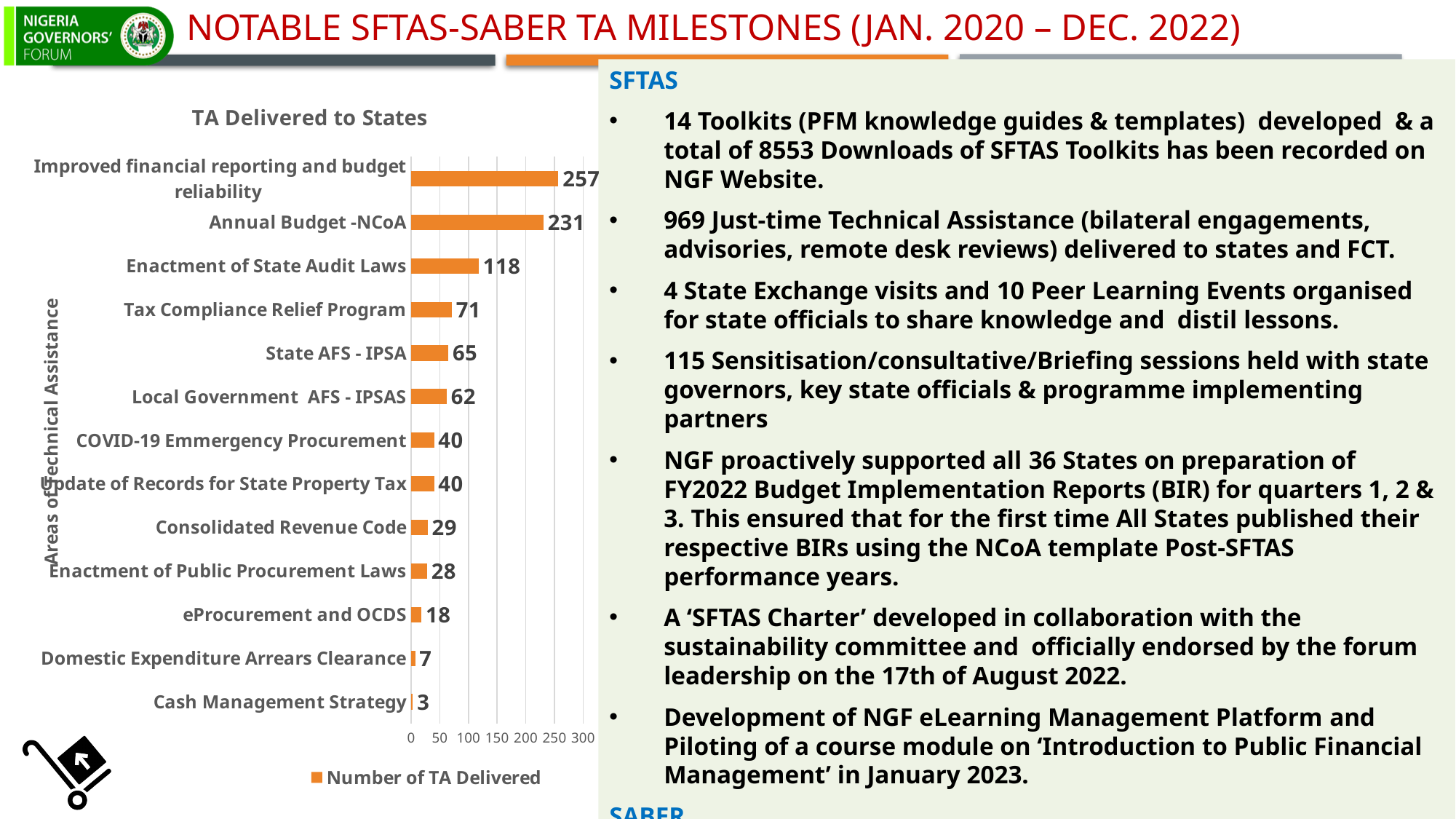
Which has more TA delivered: Tax Compliance Relief Program or State AFS - IPSA? Tax Compliance Relief Program Which area of technical assistance has the lowest number of TA delivered? Cash Management Strategy What is the number of TA delivered for Annual Budget -NCoA? 231 What is the number of TA delivered for Enactment of State Audit Laws? 118 How many areas of technical assistance are shown in the chart? 13 What is the difference between the number of TA delivered for Improved financial reporting and budget reliability and for Annual Budget -NCoA? 26 What is the number of TA delivered for eProcurement and OCDS? 18 Is the value for Enactment of State Audit Laws greater or less than 100? greater How many series does the chart legend list? 1 Which area of technical assistance has the highest number of TA delivered? Improved financial reporting and budget reliability What type of chart is used to show TA Delivered to States? Bar chart What is the title of the chart on the slide? TA Delivered to States